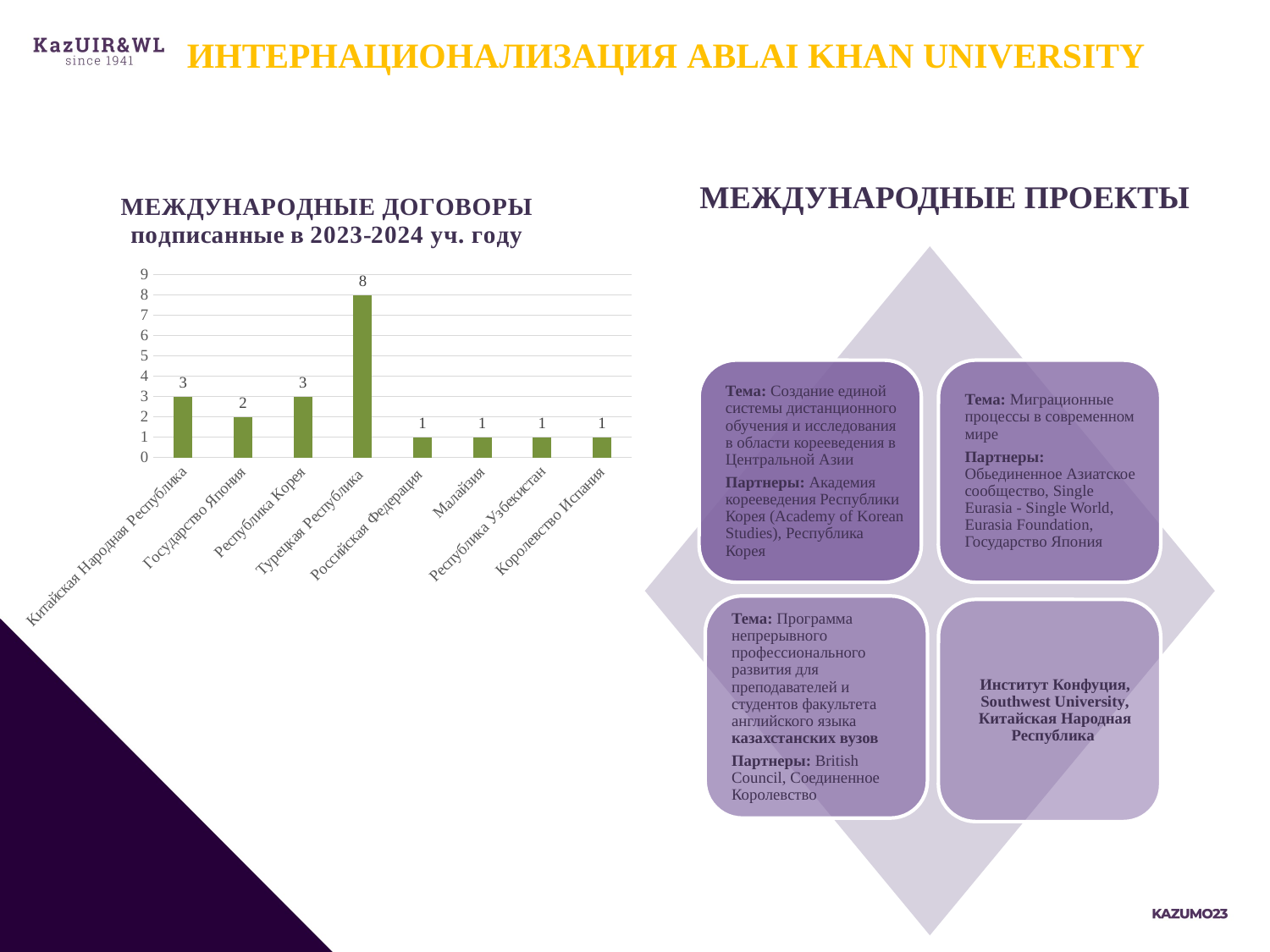
Is the value for Турецкая Республика greater or less than 5? greater How many countries have a value of 1 in the chart? 4 What is the value for Китайская Народная Республика? 3 How many countries are shown on the x axis of the chart? 8 What is the difference between the values for Турецкая Республика and Республика Корея? 5 Which country has the highest value in the chart? Турецкая Республика What type of chart is shown on the slide? bar chart Which is larger, the value for Государство Япония or the value for Российская Федерация? Государство Япония What academic year does the chart title say the agreements were signed in? 2023-2024 уч. году What is the value for Государство Япония? 2 What is the value for Турецкая Республика? 8 What is the value for Малайзия? 1